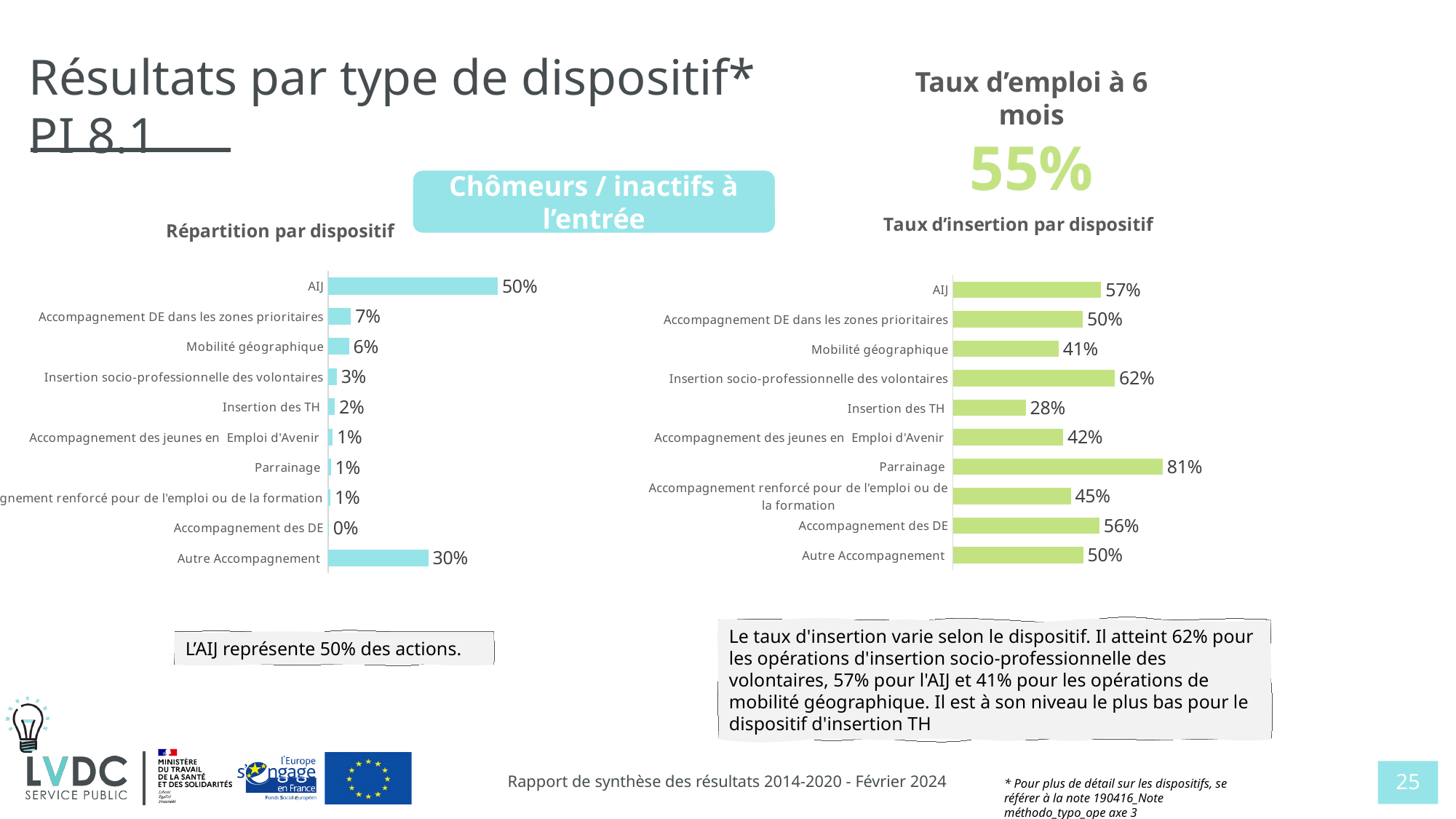
In the 'Répartition par dispositif' chart, which dispositif has the lowest value? Accompagnement des DE In the 'Taux d'insertion par dispositif' chart, what is the difference between Insertion socio-professionnelle des volontaires and Accompagnement des DE? 6 percentage points In the 'Taux d'insertion par dispositif' chart, what is the value for Parrainage? 81% In the 'Taux d'insertion par dispositif' chart, which dispositif has the highest insertion rate? Parrainage In the 'Taux d'insertion par dispositif' chart, what is the value for Insertion des TH? 28% In the 'Répartition par dispositif' chart, what is the value for AIJ? 50% In the 'Taux d'insertion par dispositif' chart, which is larger: the value for AIJ or the value for Mobilité géographique? AIJ In the 'Répartition par dispositif' chart, what is the value for Autre Accompagnement? 30% In the 'Répartition par dispositif' chart, what is the difference between AIJ and Autre Accompagnement? 20 percentage points What type of chart is the 'Répartition par dispositif' chart? Bar chart How many dispositifs are shown in the 'Taux d'insertion par dispositif' chart? 10 In the 'Taux d'insertion par dispositif' chart, which dispositif has the lowest insertion rate? Insertion des TH